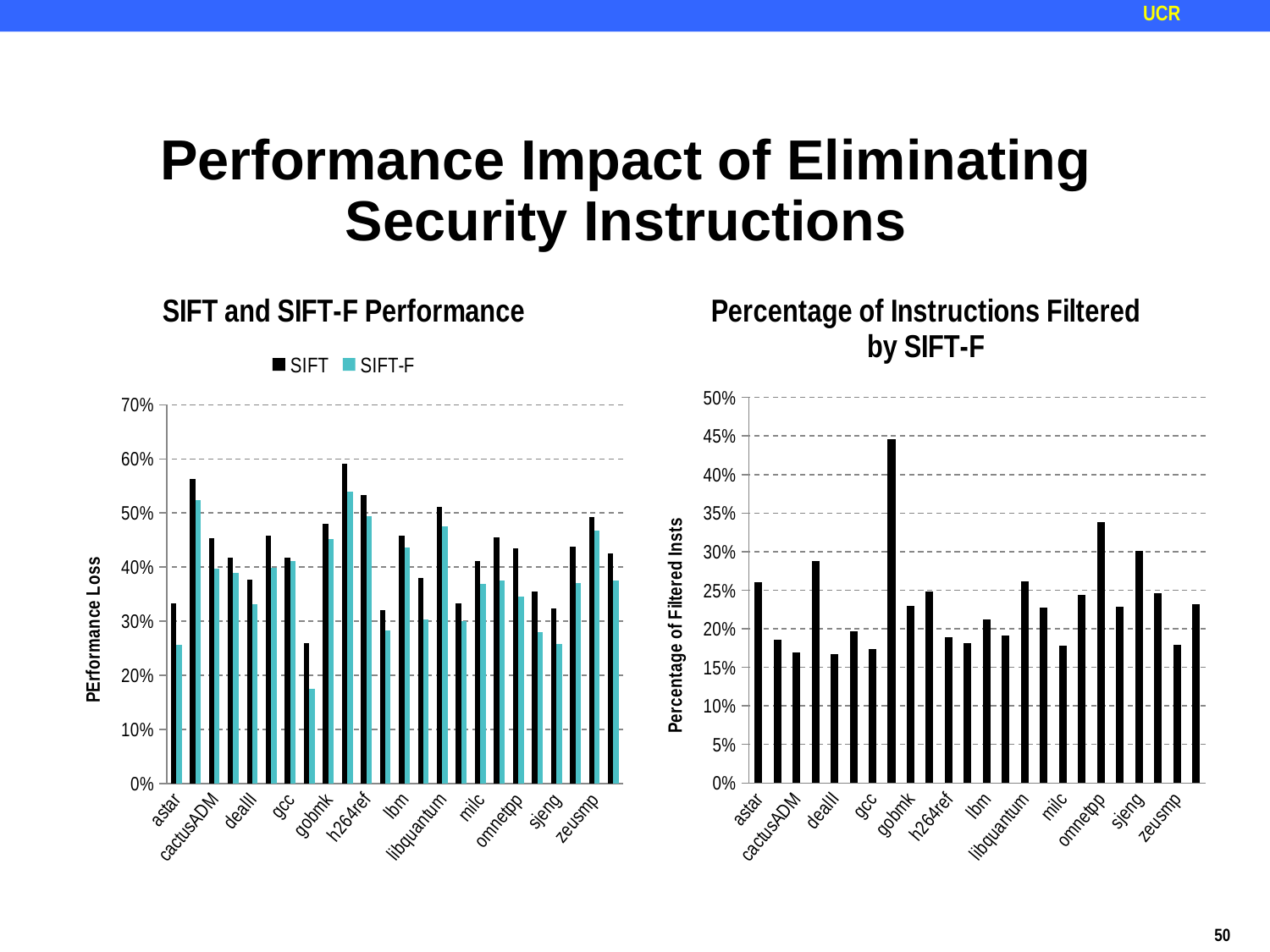
In the "Percentage of Instructions Filtered by SIFT-F" chart, is the tallest bar greater or less than 40%? greater In the "Percentage of Instructions Filtered by SIFT-F" chart, is the value for astar greater or less than 30%? less In the "SIFT and SIFT-F Performance" chart, which series has the larger value for astar, SIFT or SIFT-F? SIFT What is the y-axis title of the "Percentage of Instructions Filtered by SIFT-F" chart? Percentage of Filtered Insts What kind of chart is the "SIFT and SIFT-F Performance" chart on the left? bar chart In the "SIFT and SIFT-F Performance" chart, is the SIFT value for astar greater or less than 30%? greater What are the two series named in the legend of the "SIFT and SIFT-F Performance" chart? SIFT and SIFT-F What kind of chart is the "Percentage of Instructions Filtered by SIFT-F" chart on the right? bar chart How many series does the legend of the "SIFT and SIFT-F Performance" chart list? 2